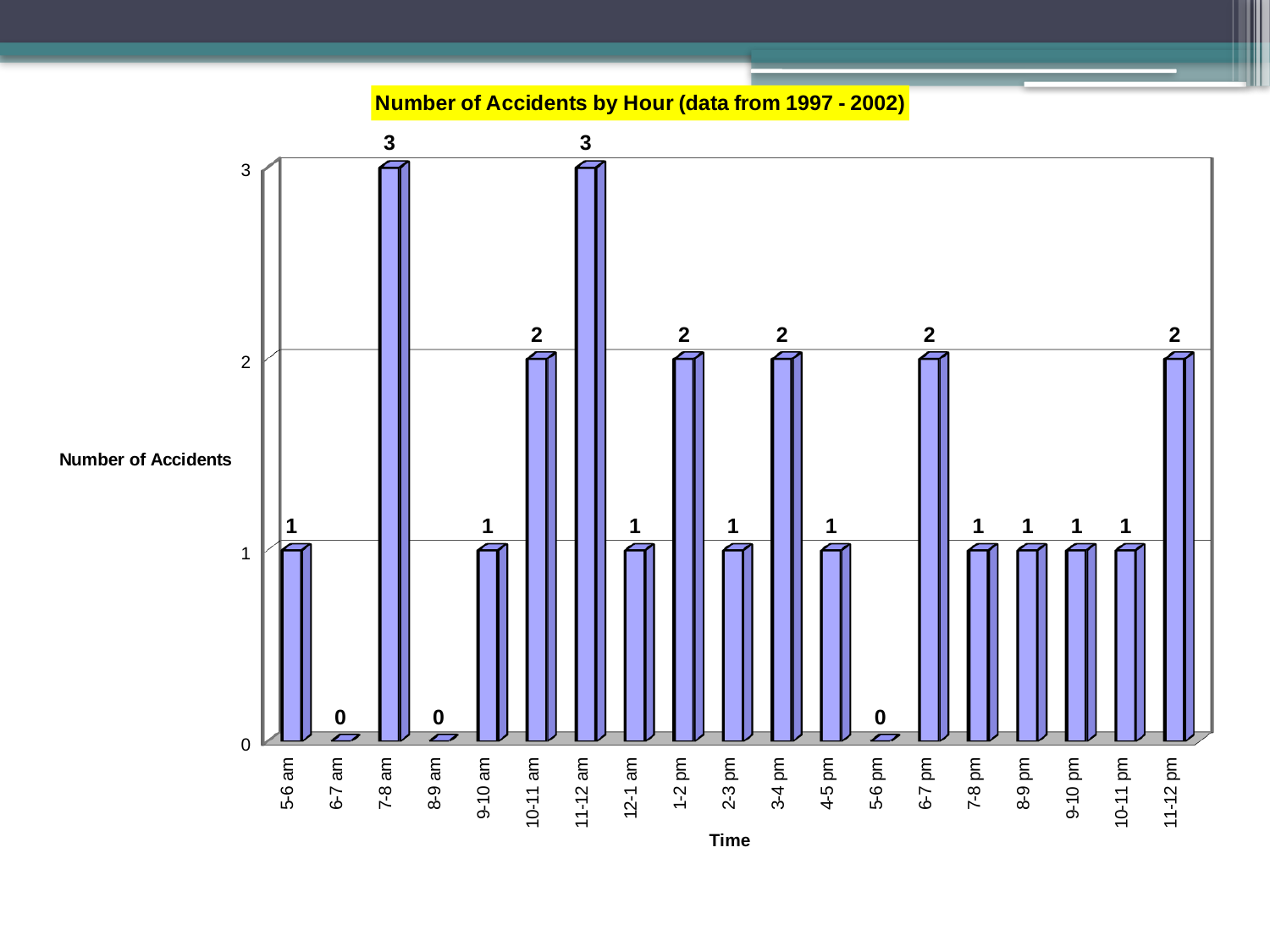
Which has more accidents, 1-2 pm or 2-3 pm? 1-2 pm What is the number of accidents for 7-8 am? 3 What is the difference between the number of accidents for 11-12 am and for 12-1 am? 2 How many time periods have 0 accidents? 3 What is the number of accidents for 10-11 am? 2 What is the title of the chart? Number of Accidents by Hour (data from 1997 - 2002) How many time periods are shown on the x axis? 19 Which time periods have the highest number of accidents? 7-8 am and 11-12 am What is the lowest number of accidents shown for any hour? 0 What is the number of accidents for 5-6 pm? 0 What kind of chart is shown on the slide? Bar chart What is the number of accidents for 11-12 pm? 2